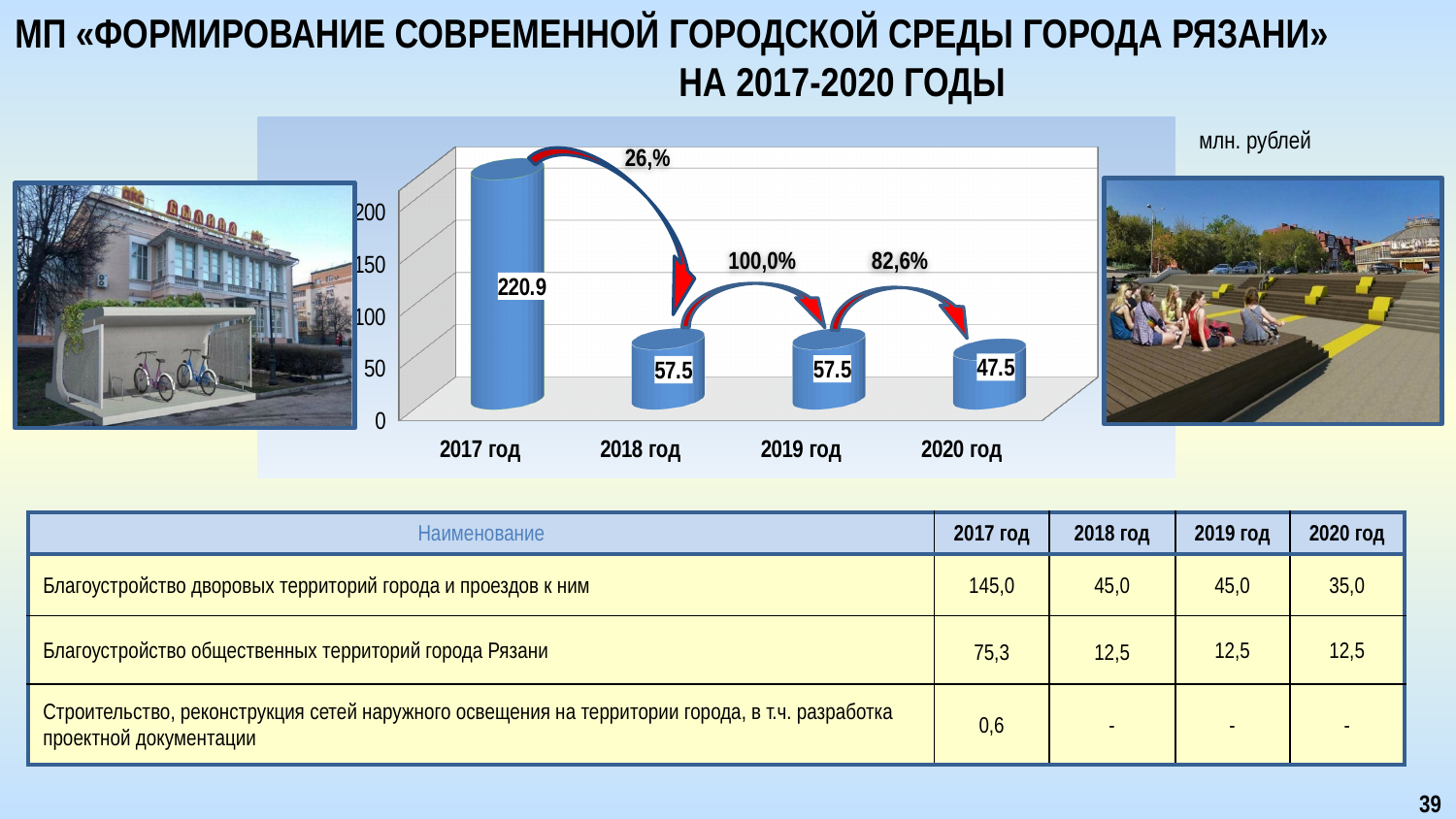
What is the difference between the values for 2019 год and 2020 год? 10 Is the value for 2017 год greater or less than 200? greater What kind of chart is shown on the slide? bar chart What is the value for 2020 год? 47.5 What is the difference between the values for 2017 год and 2018 год? 163.4 Which is larger, the value for 2019 год or the value for 2020 год? 2019 год What is the value for 2018 год? 57.5 What is the value for 2017 год? 220.9 Which year has the lowest value? 2020 год Which year has the highest value? 2017 год How many years are shown on the x axis of the chart? 4 What unit is indicated for the chart values? млн. рублей